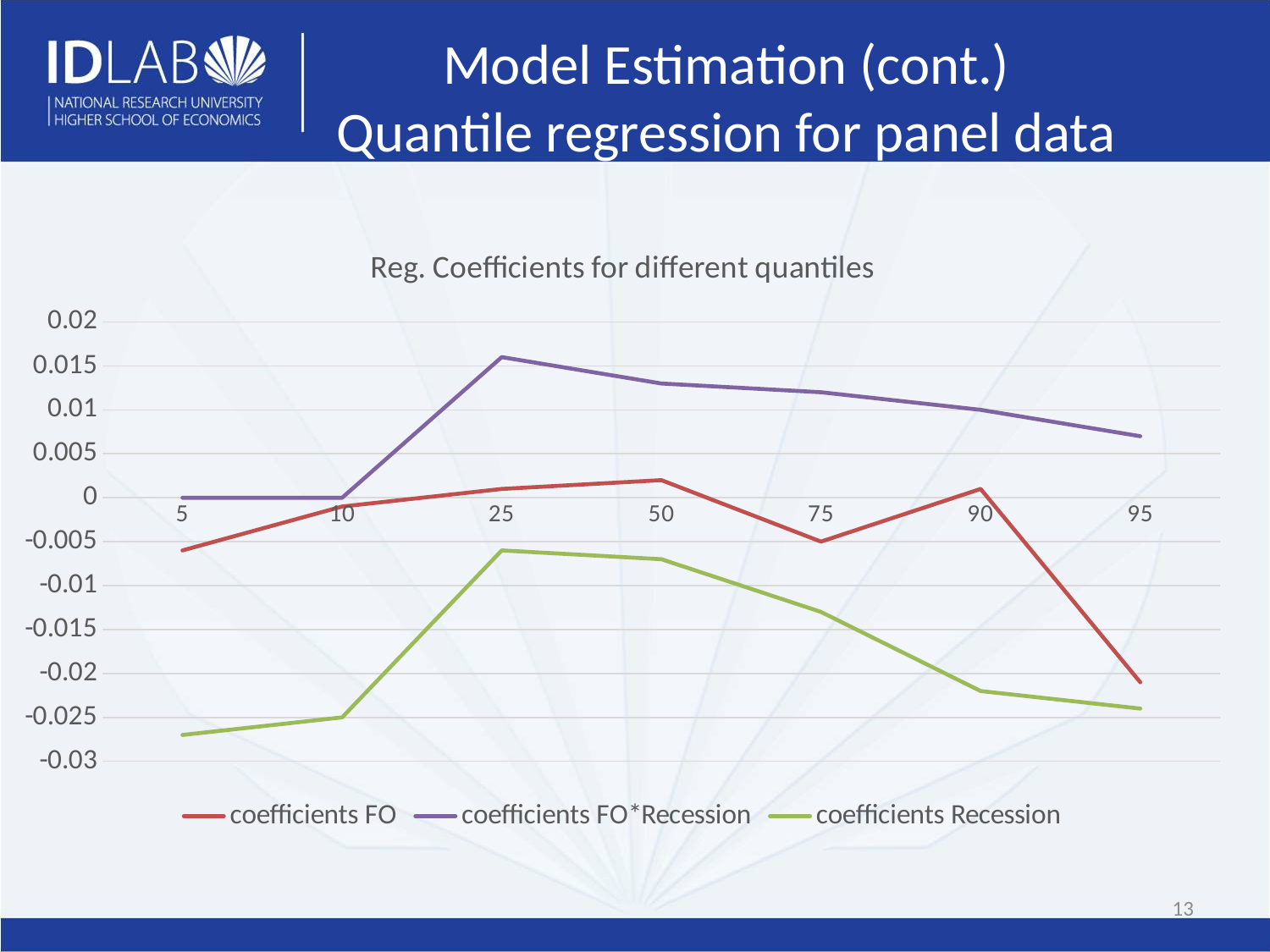
What is the value of coefficients FO*Recession at quantile 10? 0 At which quantile is the coefficients FO series lowest? 95 At which quantile is the coefficients Recession series lowest? 5 How many series does the legend list? 3 How many quantile points are plotted along the x axis? 7 Is the value of coefficients FO at quantile 95 greater or less than -0.015? less Is the value of coefficients FO*Recession at quantile 50 greater or less than 0.01? greater What is the value of coefficients Recession at quantile 10? -0.025 At which quantile does the coefficients FO*Recession series reach its highest value? 25 At quantile 50, which series has the larger value: coefficients FO or coefficients FO*Recession? coefficients FO*Recession What kind of chart is shown on the slide? line chart What is the title of the chart? Reg. Coefficients for different quantiles